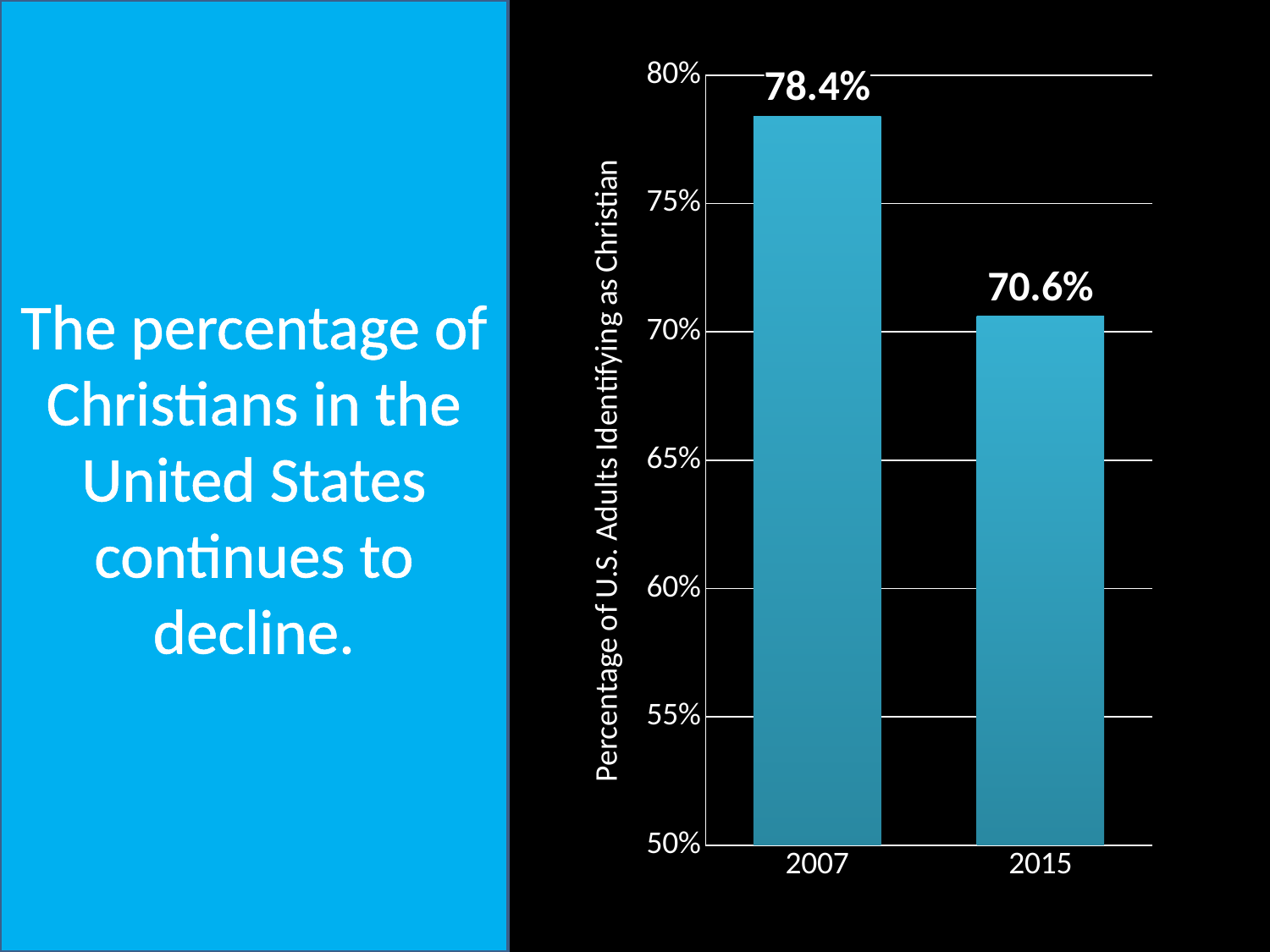
What is the label on the vertical axis of the chart? Percentage of U.S. Adults Identifying as Christian Is the value for 2015 greater or less than 75%? less What is the percentage of U.S. adults identifying as Christian in 2007? 78.4% How many years are shown on the chart? 2 By how many percentage points did the share of U.S. adults identifying as Christian fall from 2007 to 2015? 7.8 percentage points Which year has the higher percentage of U.S. adults identifying as Christian? 2007 What kind of chart is shown on the slide? bar chart Which year has the lower percentage of U.S. adults identifying as Christian? 2015 Is the value for 2007 greater or less than 75%? greater Is the value for 2007 larger or smaller than the value for 2015? larger What is the percentage of U.S. adults identifying as Christian in 2015? 70.6% Does the percentage of U.S. adults identifying as Christian rise or fall from 2007 to 2015? fall